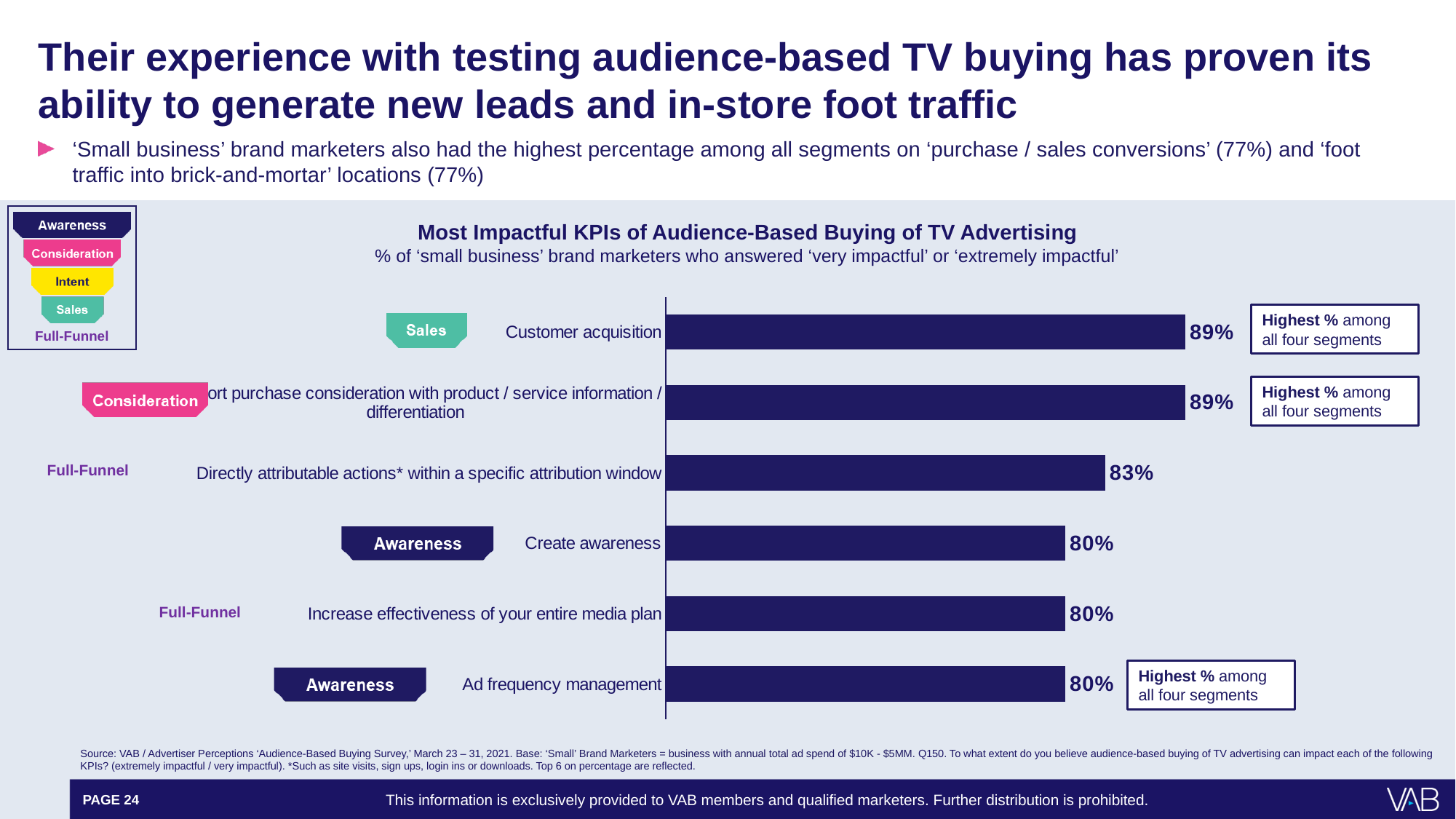
Do the bar values rise or fall going from the top of the chart to the bottom? fall What kind of chart is shown on the slide? bar chart What is the highest percentage value shown in the chart? 89% What is the lowest percentage value shown in the chart? 80% How many KPIs (bars) are plotted in the chart? 6 Which has a larger value: 'Directly attributable actions* within a specific attribution window' or 'Increase effectiveness of your entire media plan'? Directly attributable actions* within a specific attribution window What percentage is shown for 'Ad frequency management'? 80% What percentage is shown for 'Customer acquisition'? 89% What percentage is shown for 'Create awareness'? 80% What percentage is shown for 'Directly attributable actions* within a specific attribution window'? 83% What is the title of the chart? Most Impactful KPIs of Audience-Based Buying of TV Advertising What is the difference in percentage points between 'Customer acquisition' and 'Create awareness'? 9 percentage points